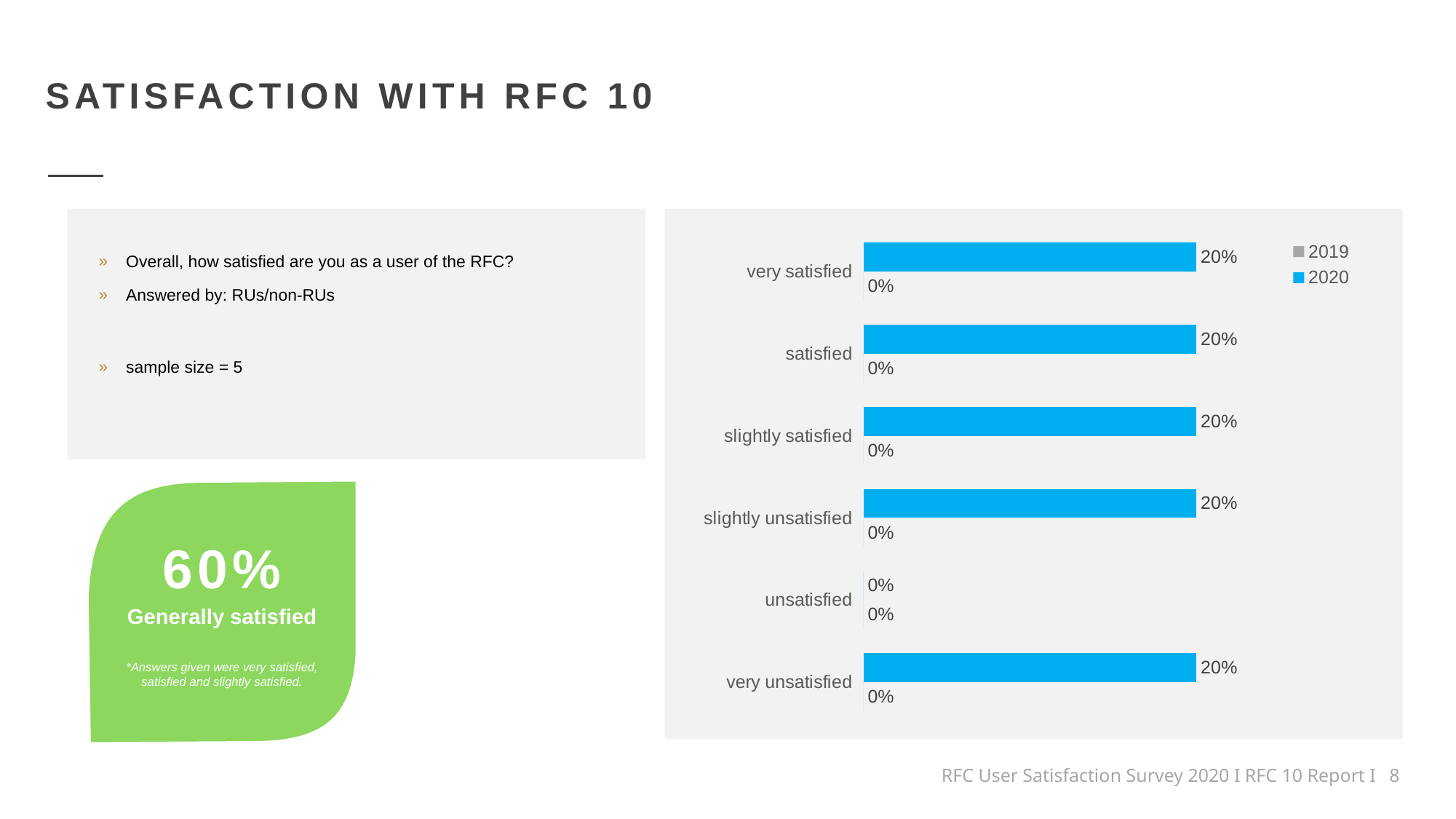
What is the 2019 value for "satisfied"? 0% How many series does the legend list? 2 What is the 2020 value for "very satisfied"? 20% What is the 2019 value for "very unsatisfied"? 0% What is the 2020 value for "unsatisfied"? 0% Which series is shown in blue? 2020 What is the 2020 value for "very unsatisfied"? 20% What kind of chart is shown on the slide? bar chart Which category has the lowest 2020 value? unsatisfied How many categories are shown on the chart? 6 What is the difference between the 2020 and 2019 values for "slightly satisfied"? 20% Which is larger for 2020: "very satisfied" or "unsatisfied"? very satisfied